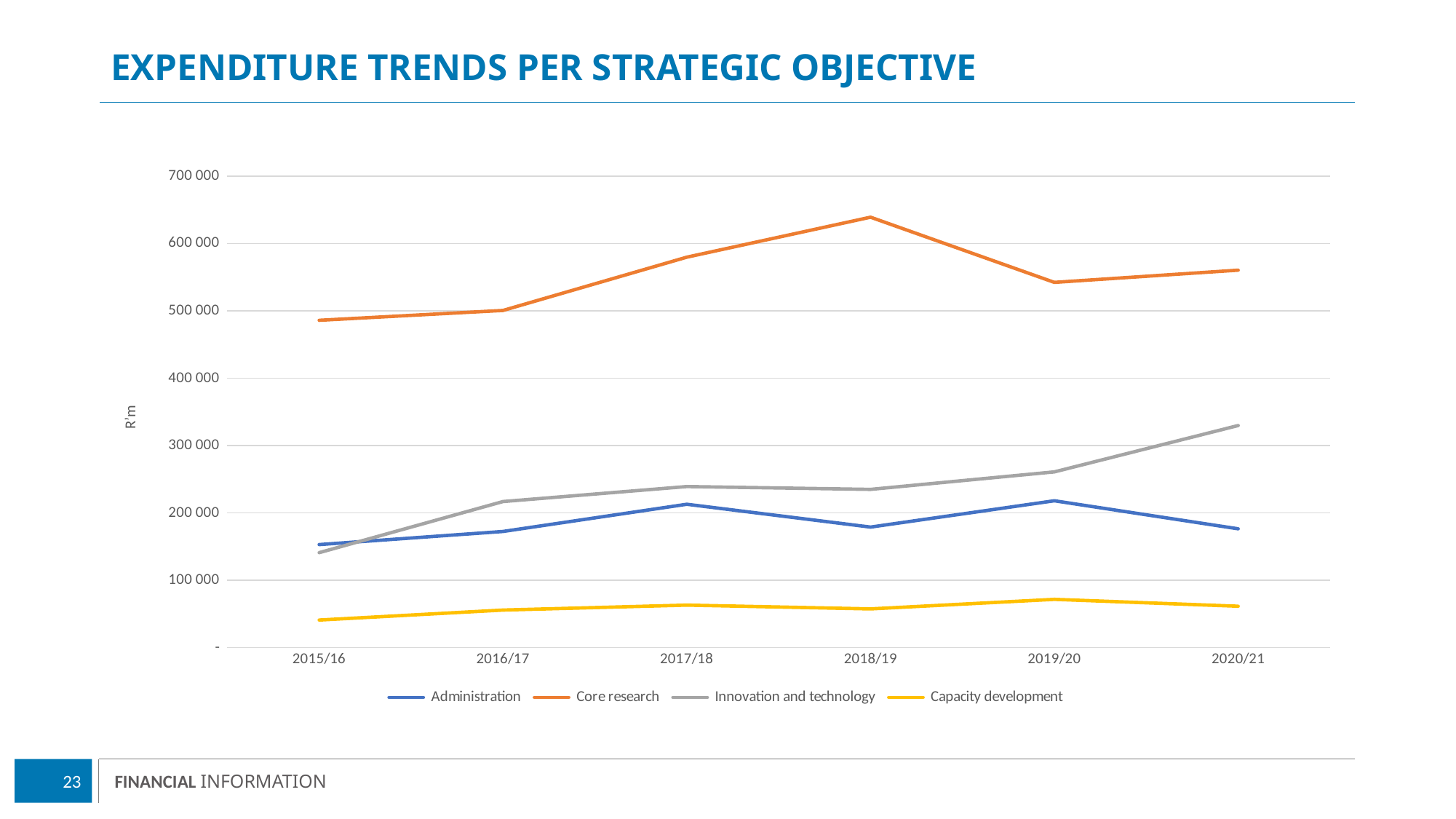
In which year does Core research expenditure reach its peak? 2018/19 Which series has the highest expenditure in every year shown? Core research Is the value for Innovation and technology in 2020/21 greater or less than 300 000? greater What kind of chart is shown on the slide? line chart How many financial years are shown on the x axis? 6 Which series has the lowest expenditure in every year shown? Capacity development How many series does the legend list? 4 Does Innovation and technology expenditure rise or fall from 2018/19 to 2020/21? rise Is the value for Capacity development in 2019/20 greater or less than 100 000? less Is the value for Core research in 2018/19 greater or less than 600 000? greater In 2020/21, which is larger: Innovation and technology or Administration? Innovation and technology